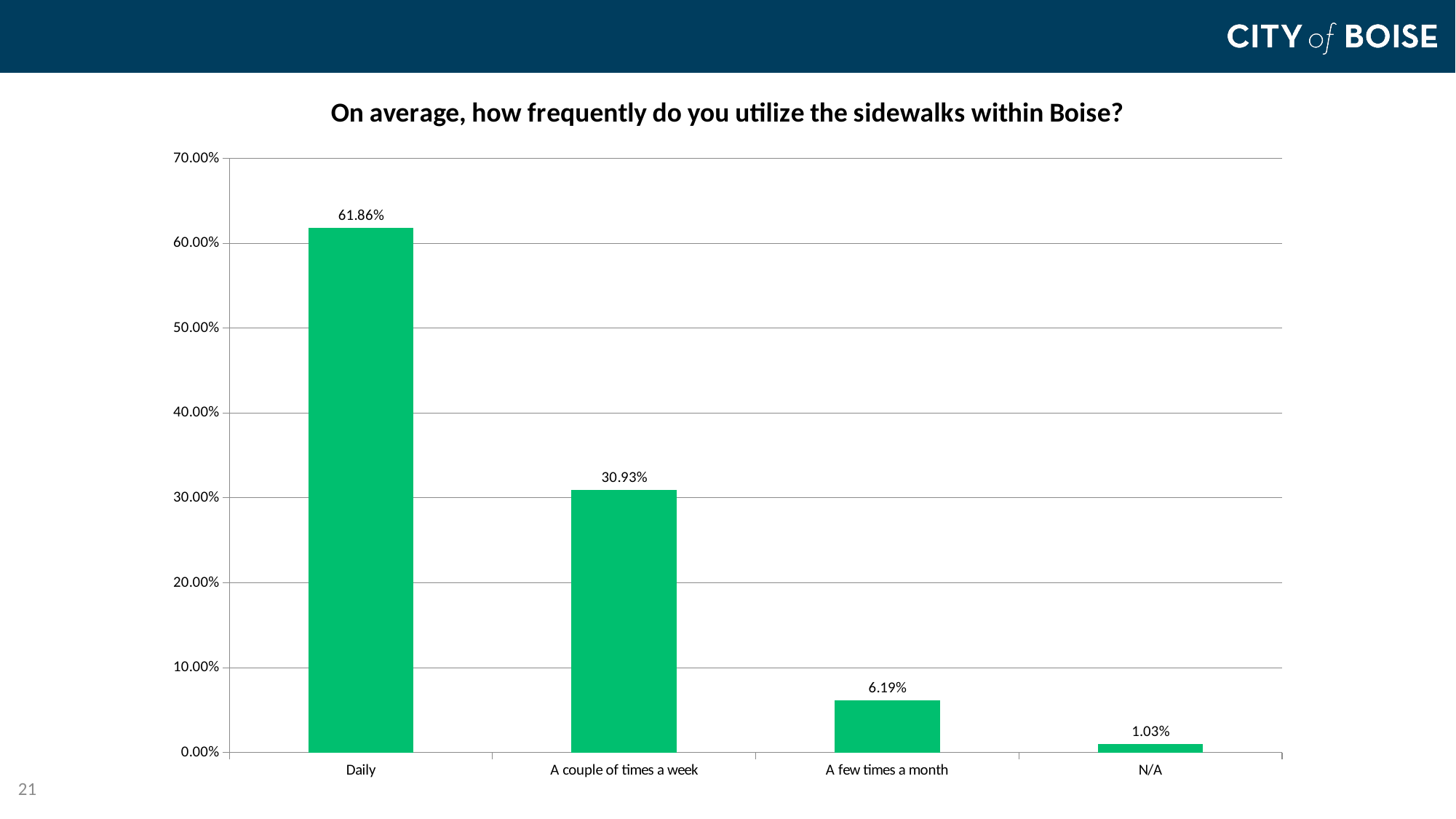
What is the difference between the Daily value and the 'A couple of times a week' value? 30.93% What kind of chart is shown on the slide? Bar chart What is the value for 'A couple of times a week'? 30.93% Which category has the lowest value? N/A What percentage of respondents said they use the sidewalks within Boise daily? 61.86% What is the title of the chart? On average, how frequently do you utilize the sidewalks within Boise? Which category has the highest value? Daily Which is larger, the value for 'A few times a month' or the value for N/A? A few times a month How many categories are shown on the x axis? 4 What is the value for 'A few times a month'? 6.19% What is the value for the N/A category? 1.03% Is the value for Daily greater or less than 60.00%? greater